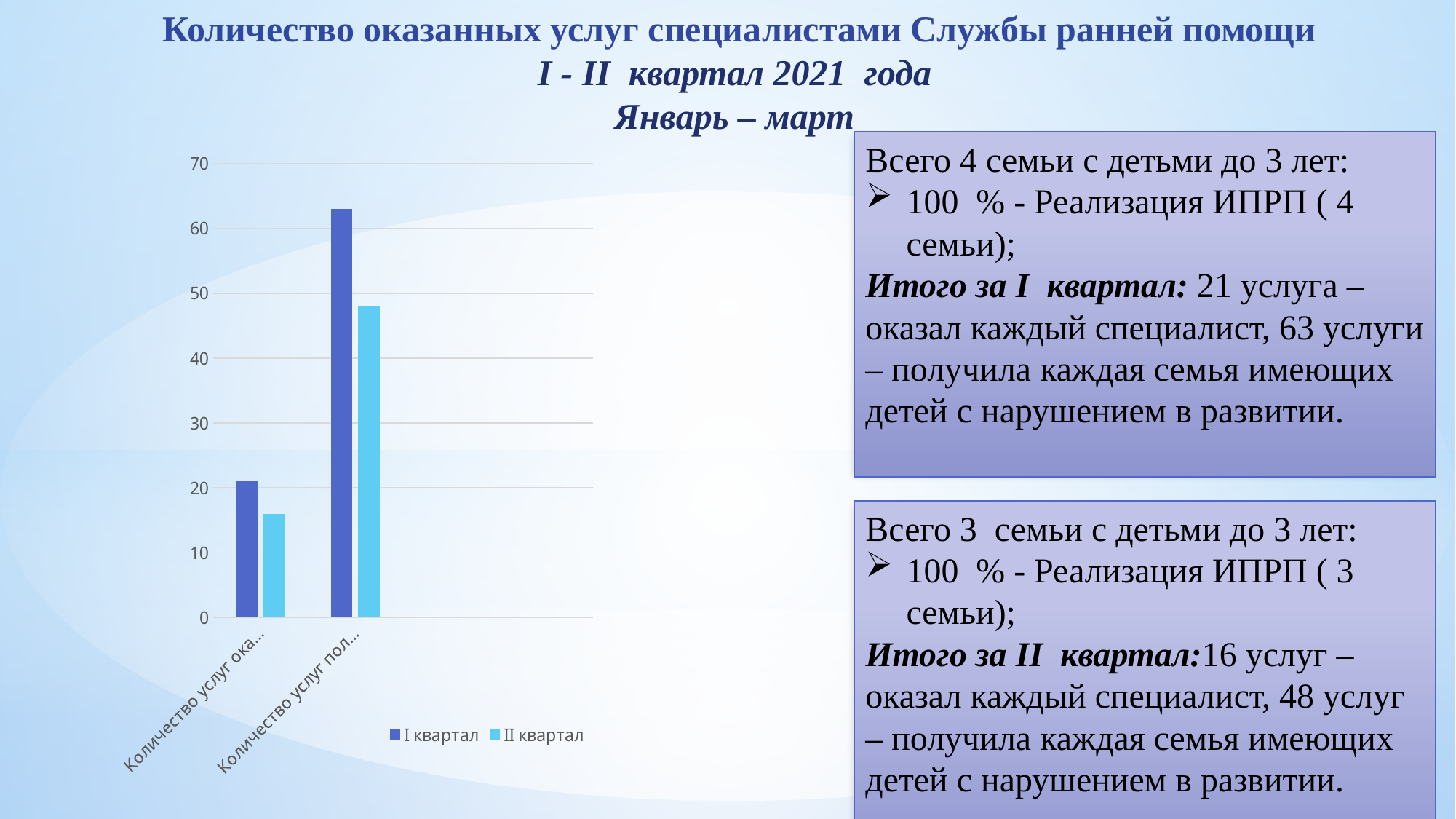
Which series is shown in dark blue in the chart? I квартал How many series does the chart legend list? 2 What are the two series named in the chart legend? I квартал and II квартал Is the I квартал value for the first category (Количество услуг ока...) greater or less than 30? less How many categories are plotted on the x axis of the chart? 2 Do the values for the I квартал series rise or fall from the first category to the second category? rise In the second category (Количество услуг пол...), which series has the taller bar? I квартал What kind of chart is shown on the slide? bar chart Is the I квартал value for the second category (Количество услуг пол...) greater or less than 60? greater Is the II квартал value for the second category (Количество услуг пол...) greater or less than 50? less In the first category (Количество услуг ока...), which series has the taller bar? I квартал